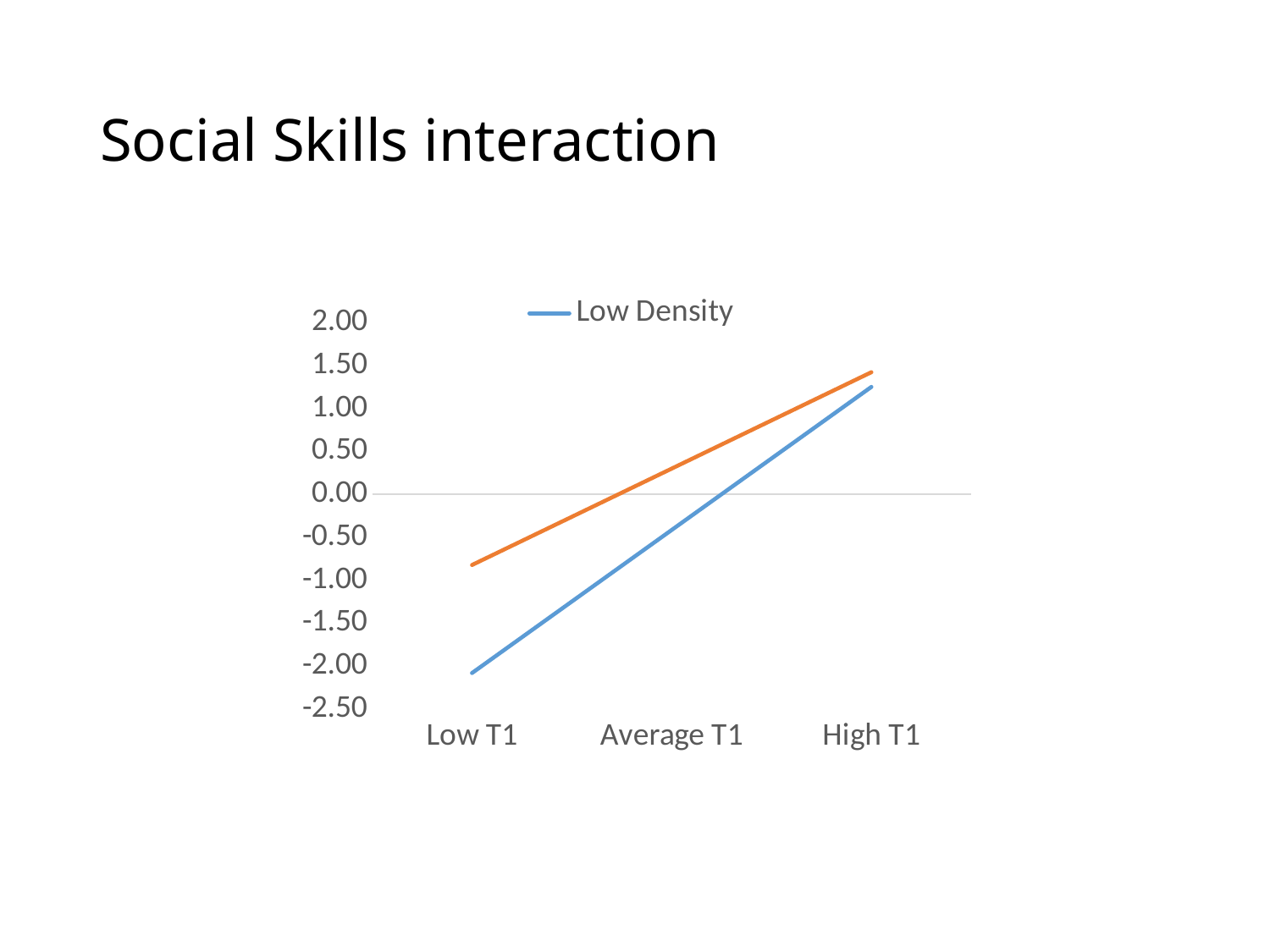
Is the value of the orange line at High T1 greater or less than 1.00? greater At Low T1, which line has the higher value, the Low Density line or the orange line? the orange line Is the value of the orange line at Low T1 greater or less than -0.50? less Which series name is shown in the chart legend? Low Density Is the value of the Low Density line at High T1 greater or less than 1.00? greater Does the Low Density line rise or fall from Low T1 to High T1? rise Does the orange line rise or fall from Low T1 to High T1? rise How many lines are plotted on the chart? 2 What is the title of the slide? Social Skills interaction How many categories are shown on the x axis? 3 What kind of chart is shown on the slide? line chart